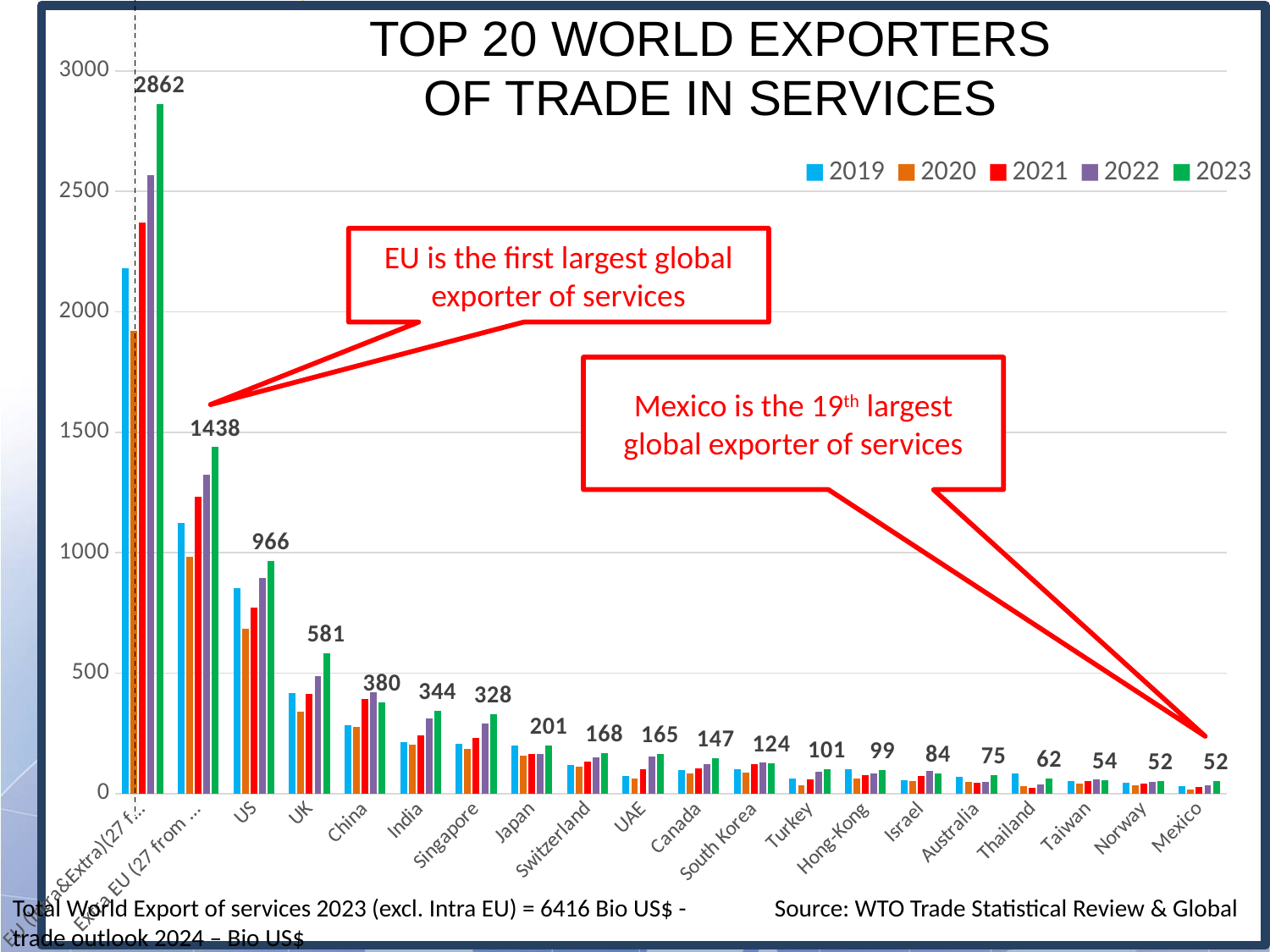
What kind of chart is shown on the slide? bar chart What is the difference between the 2023 values for Japan and Switzerland? 33 How many exporter categories are shown on the x axis? 20 How many series does the legend list? 5 What is the 2023 value for the US? 966 What is the difference between the 2023 values for the US and the UK? 385 What is the highest 2023 value labelled on the chart? 2862 What is the 2023 value for China? 380 Is the 2019 value for the US greater or less than 1000? less Do the 2023 values rise or fall moving from left to right along the x axis? fall Which has the larger 2023 value, India or Singapore? India What is the 2023 value for Mexico? 52